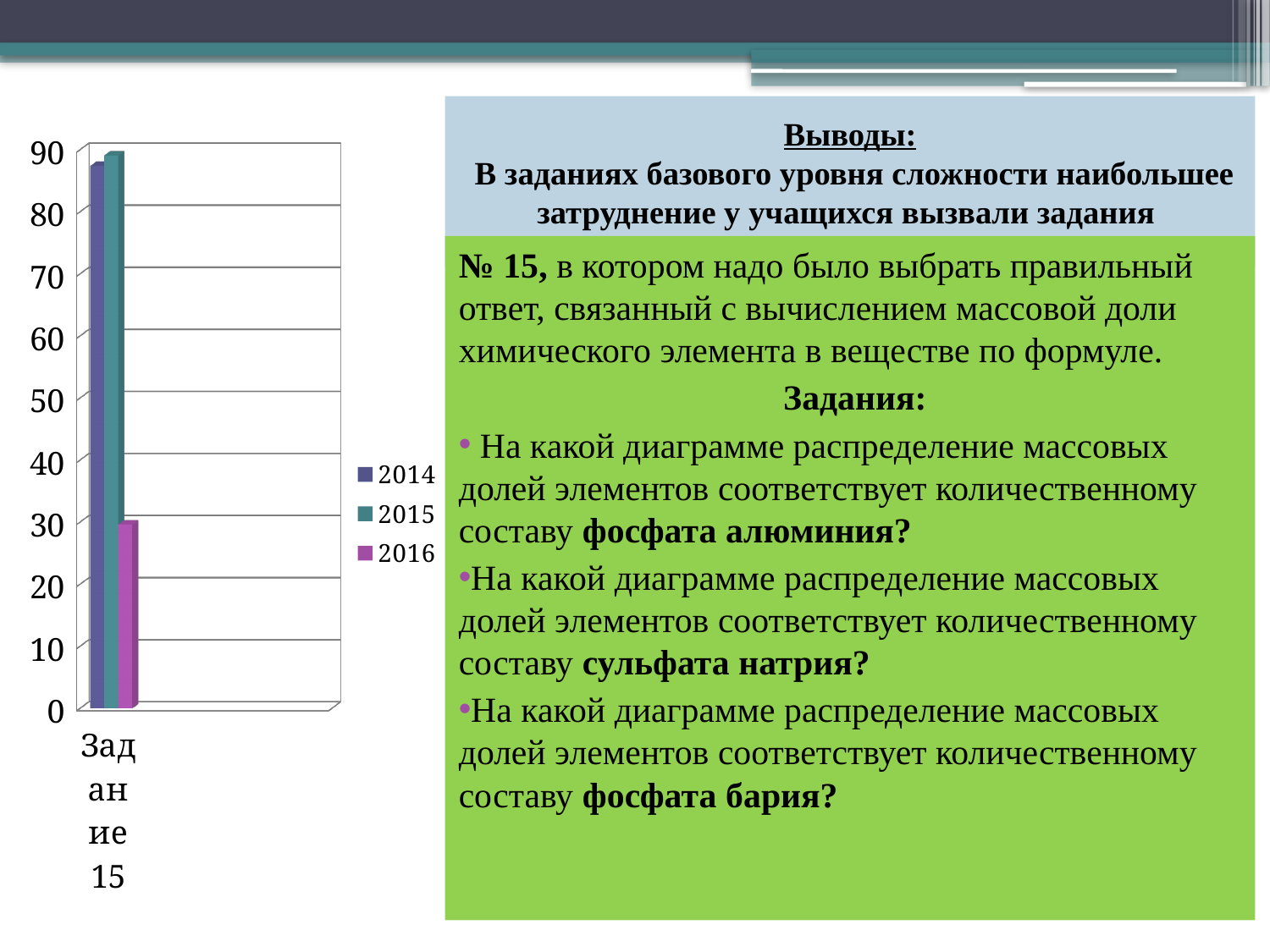
What is the category label on the x axis of the chart? Задание 15 How many series does the chart legend list? 3 Which series has the lowest value for Задание 15? 2016 What are the entries listed in the chart legend? 2014, 2015, 2016 Is the value for 2016 for Задание 15 greater or less than 20? greater Which is larger for Задание 15, the value for 2015 or the value for 2016? 2015 Is the value for 2014 for Задание 15 greater or less than 80? greater Is the value for 2015 for Задание 15 greater or less than 80? greater What kind of chart is shown on the slide? bar chart Which is larger for Задание 15, the value for 2014 or the value for 2016? 2014 How many categories are shown on the x axis of the chart? 1